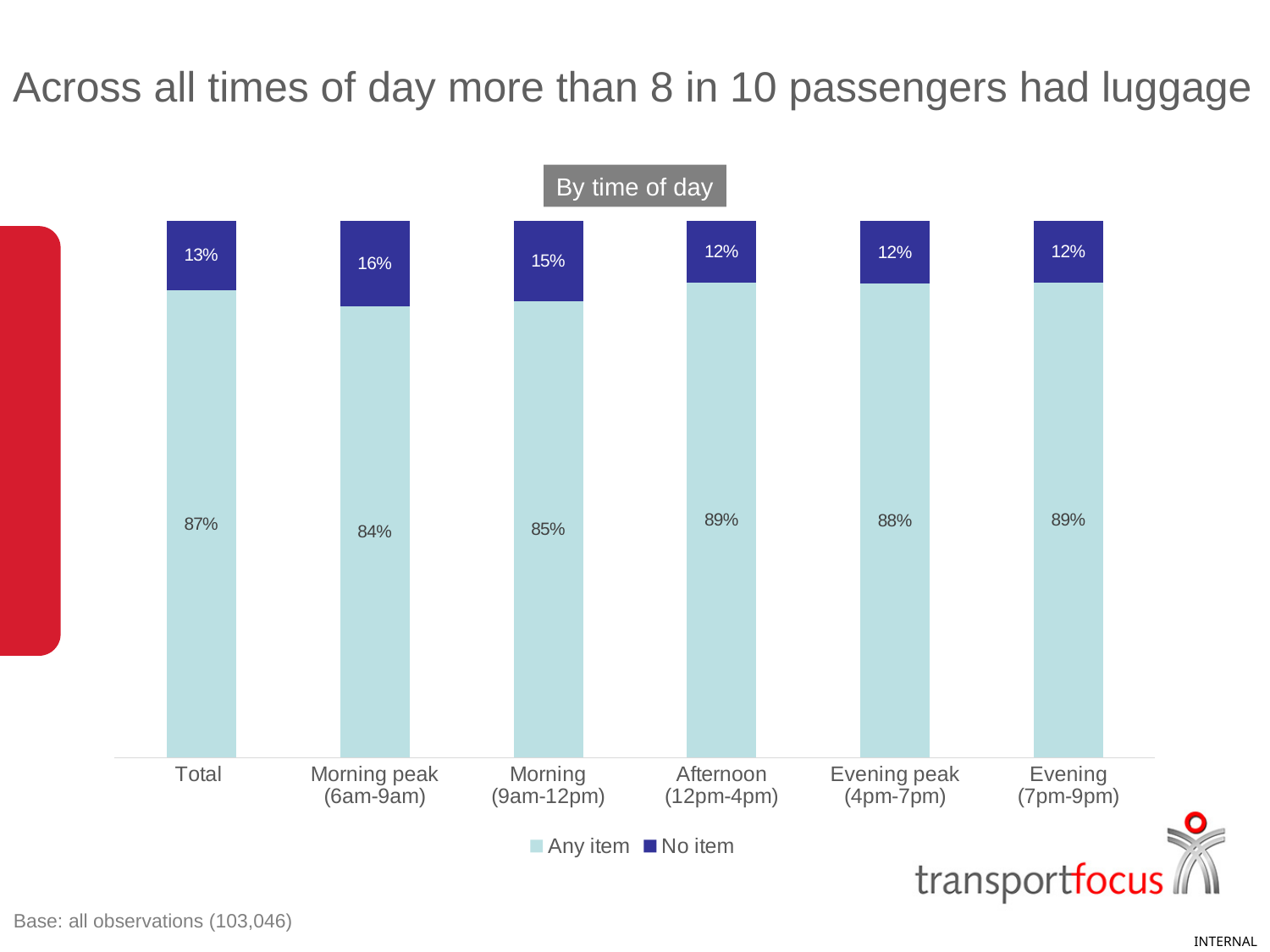
Which time of day has the highest 'No item' percentage? Morning peak (6am-9am) What is the difference between the 'Any item' values for Afternoon (12pm-4pm) and Morning (9am-12pm)? 4% How many series does the legend list? 2 Which time of day has the lowest 'Any item' percentage? Morning peak (6am-9am) How many categories are shown on the x axis? 6 What is the 'Any item' value for the Total category? 87% Which is larger, the 'No item' value for Morning (9am-12pm) or for Evening peak (4pm-7pm)? Morning (9am-12pm) What is the title shown above the chart? By time of day What percentage of passengers in the Morning peak (6am-9am) had any item of luggage? 84% What is the 'No item' value for the Evening (7pm-9pm) category? 12% What is the total of the stacked bar for Evening peak (4pm-7pm)? 100% What kind of chart is shown on the slide? Stacked bar chart